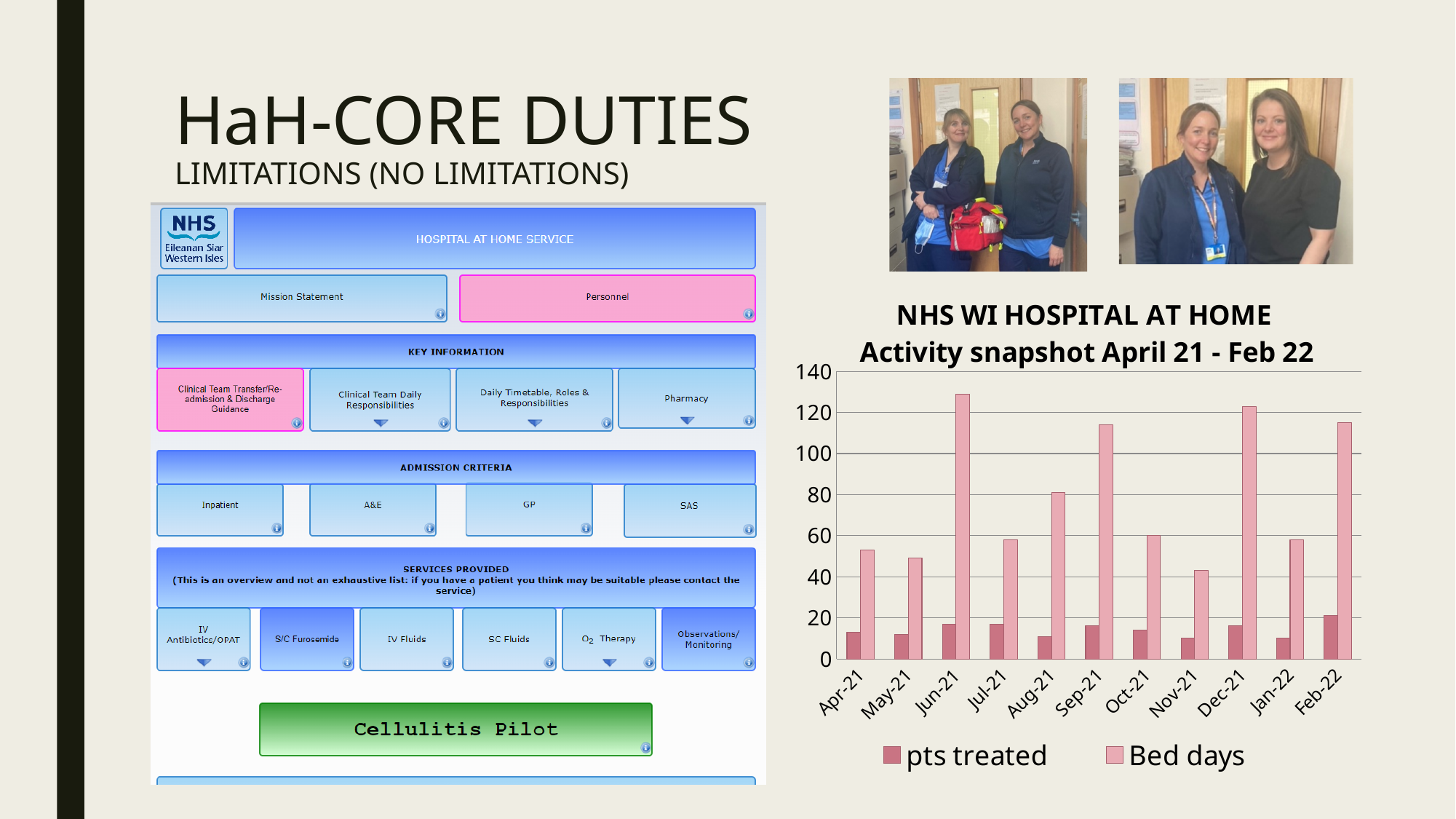
What kind of chart is shown on the slide? bar chart Is the value for Bed days in Aug-21 greater or less than 60? greater Is the value for Bed days in Jun-21 greater or less than 120? greater Which is larger, Bed days in Sep-21 or Bed days in Oct-21? Sep-21 How many series does the chart legend list? 2 Which is larger, Bed days in Dec-21 or Bed days in Jan-22? Dec-21 How many months are shown on the x axis of the chart? 11 What is the title of the chart? NHS WI HOSPITAL AT HOME Activity snapshot April 21 - Feb 22 Which month has the highest value for pts treated? Feb-22 Which two series are listed in the chart legend? pts treated and Bed days Is the value for Bed days in Nov-21 greater or less than 60? less